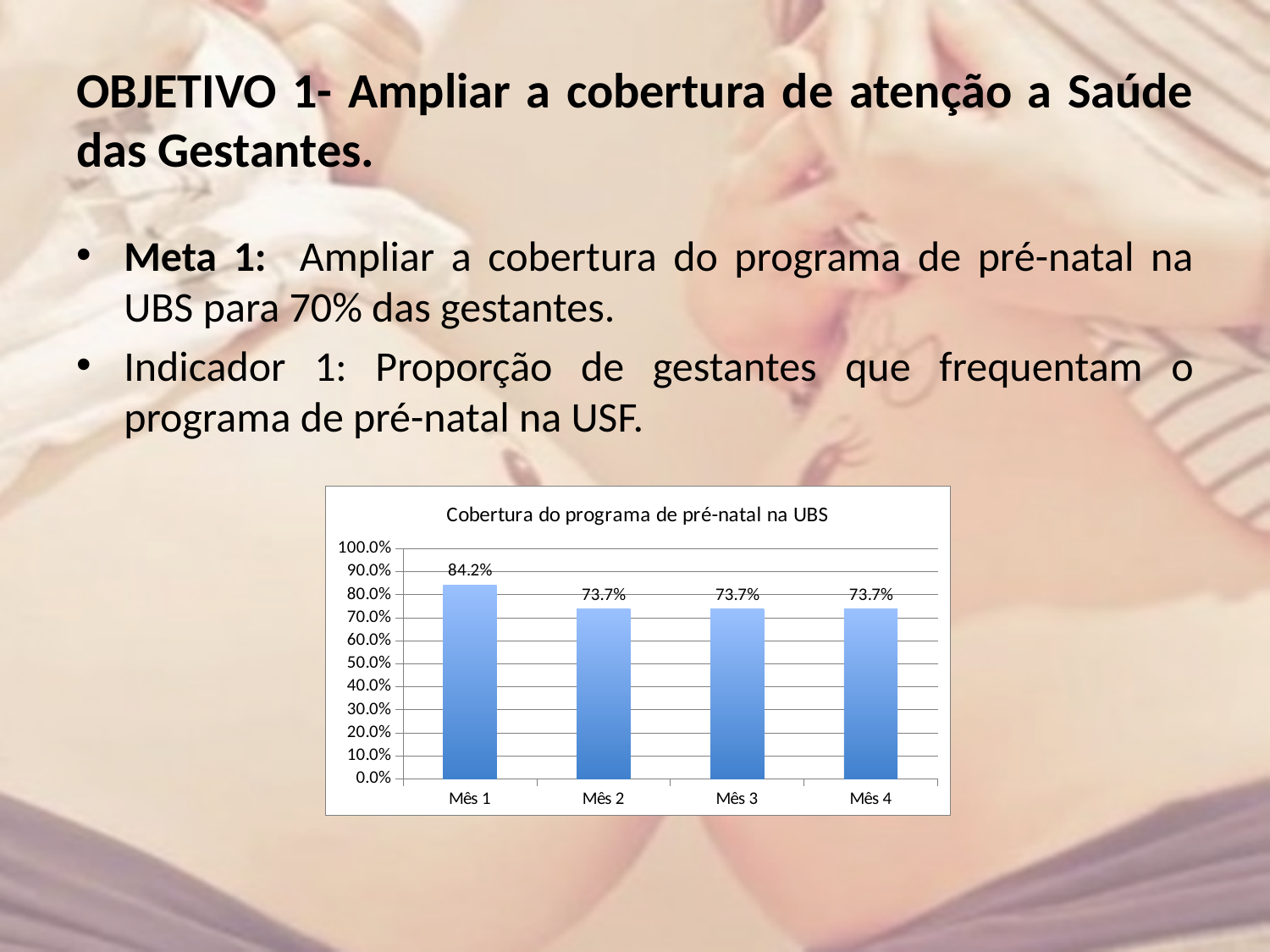
Which month has the highest value? Mês 1 What is the highest value shown on the y axis? 100.0% What is the value for Mês 1? 84.2% What is the difference between the values for Mês 1 and Mês 2? 10.5% Is the value for Mês 1 greater or less than 90.0%? less What is the title of the chart? Cobertura do programa de pré-natal na UBS Which is larger, the value for Mês 1 or the value for Mês 4? Mês 1 Do the values rise or fall from Mês 1 to Mês 2? fall What kind of chart is shown? bar chart What is the value for Mês 3? 73.7% How many months are shown on the x axis? 4 Is the value for Mês 2 greater or less than 70.0%? greater